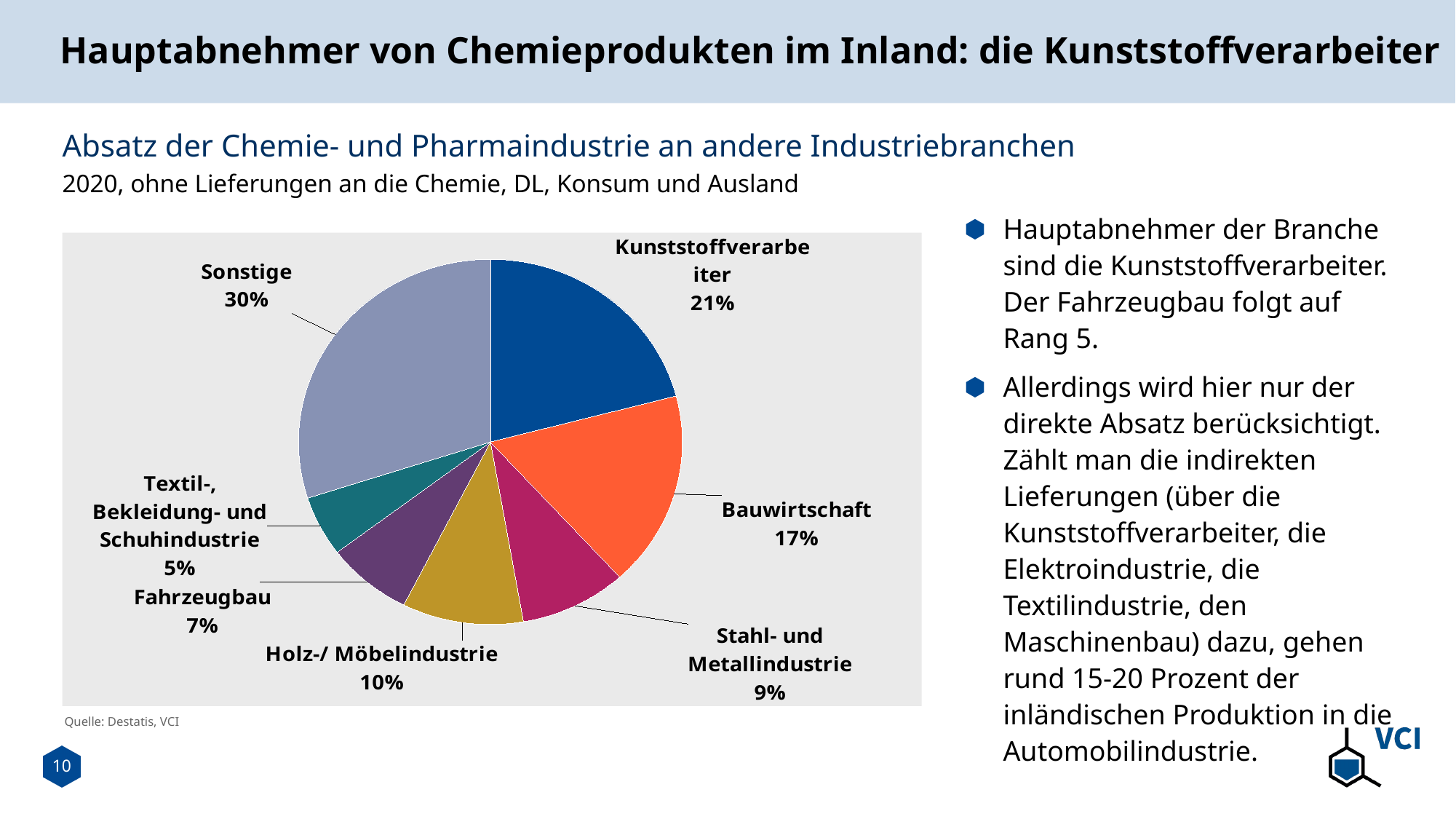
What share of the pie does Bauwirtschaft have? 17% Which slice of the pie is the largest? Sonstige What share of the pie does Holz-/ Möbelindustrie have? 10% What is the difference in percentage points between Kunststoffverarbeiter and Bauwirtschaft? 4 What is the combined share of Fahrzeugbau and Textil-, Bekleidung- und Schuhindustrie? 12% What share of the pie does Fahrzeugbau have? 7% Which slice of the pie is the smallest? Textil-, Bekleidung- und Schuhindustrie What kind of chart is shown on the slide? Pie chart How many slices does the pie chart have? 7 Which is larger, the share for Stahl- und Metallindustrie or the share for Holz-/ Möbelindustrie? Holz-/ Möbelindustrie What is the title of the chart? Absatz der Chemie- und Pharmaindustrie an andere Industriebranchen